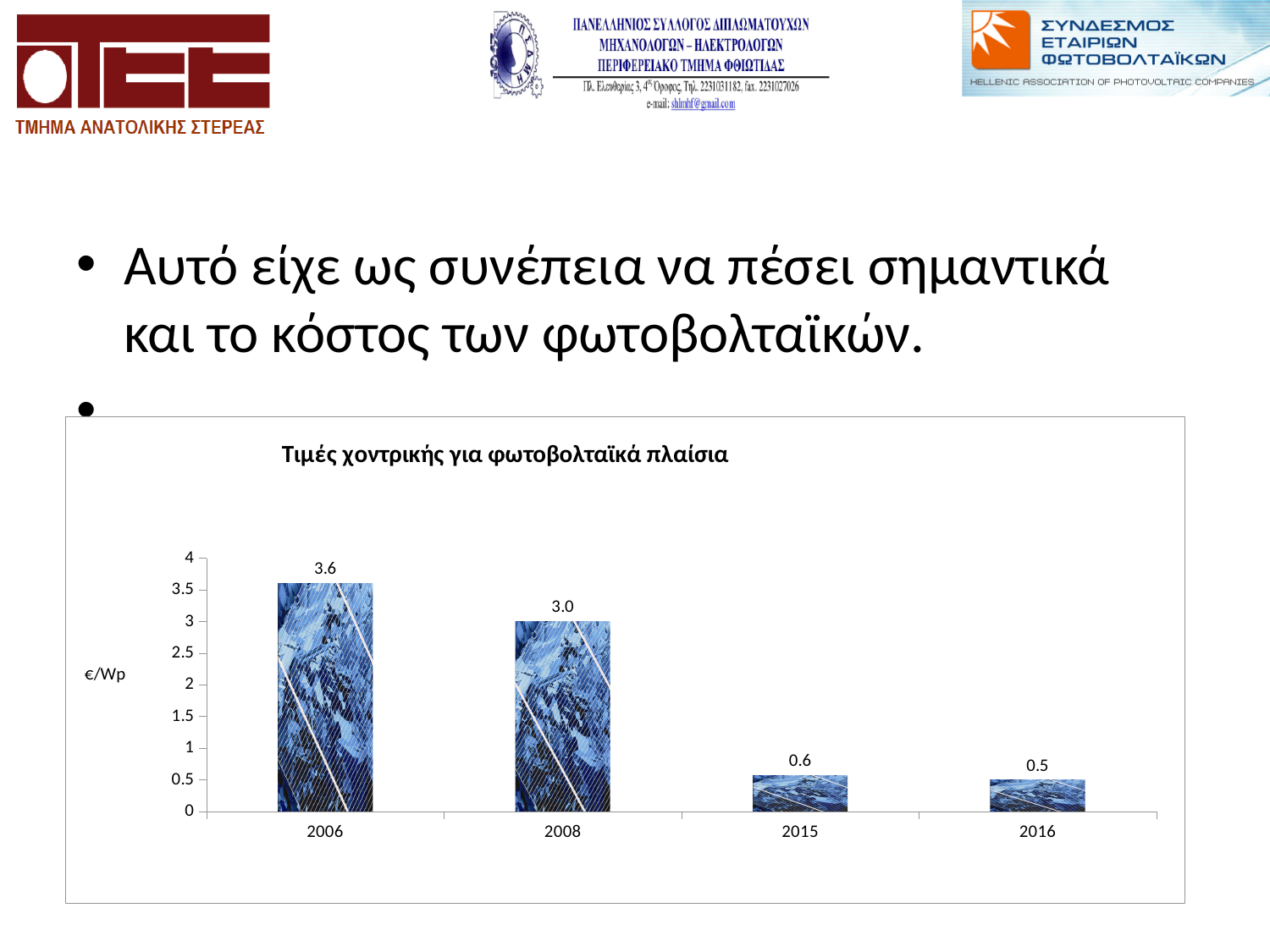
What is the value for 2006? 3.6 How many years are shown on the x axis? 4 What is the difference between the values for 2008 and 2015? 2.4 What kind of chart is this? bar chart What is the value for 2015? 0.6 Do the values rise or fall from 2006 to 2016? fall What is the difference between the values for 2006 and 2016? 3.1 What is the value for 2016? 0.5 What is the value for 2008? 3.0 Which is larger, the value for 2008 or the value for 2015? 2008 Which year has the highest value? 2006 Which year has the lowest value? 2016